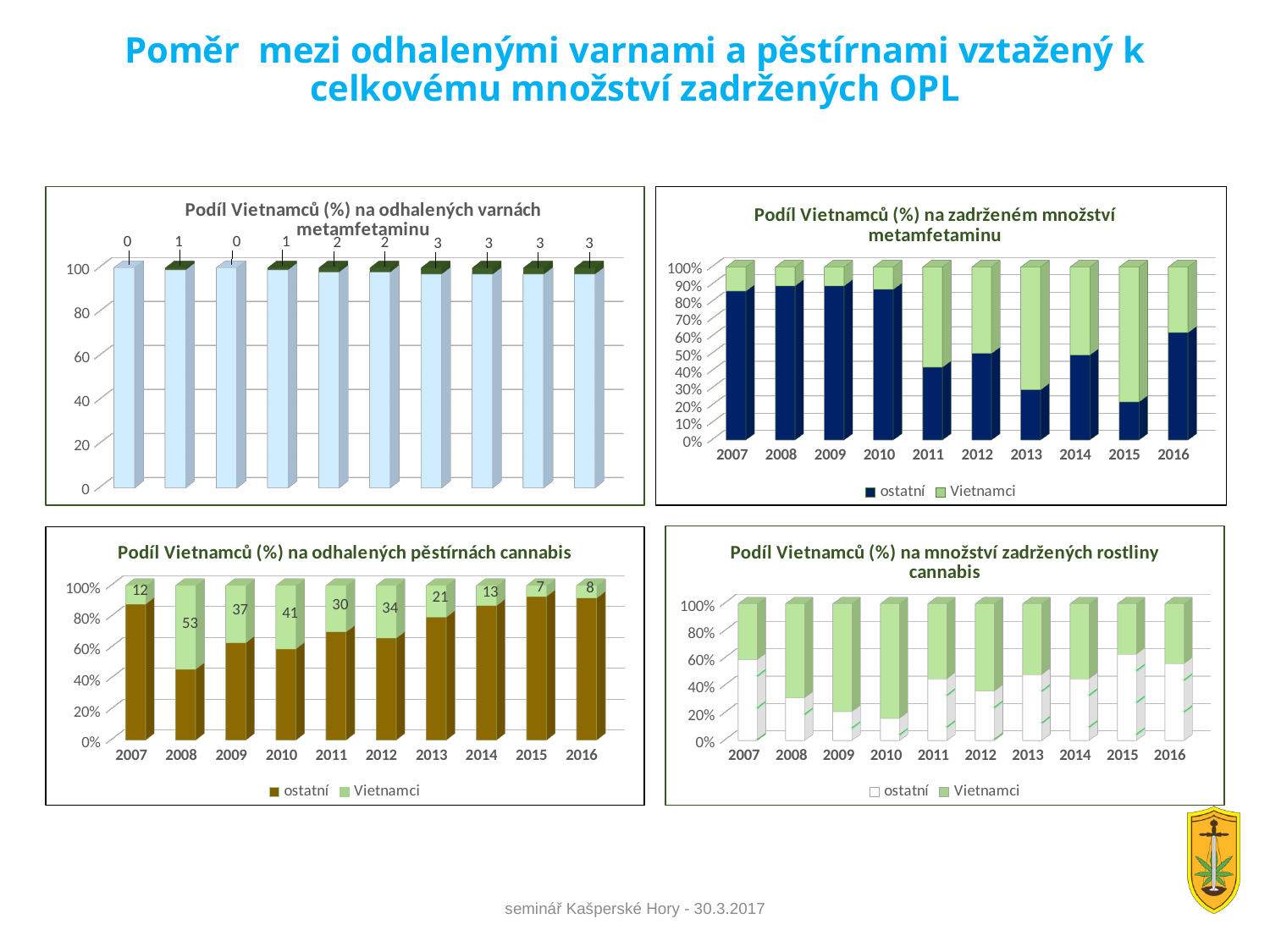
In the chart 'Podíl Vietnamců (%) na odhalených pěstírnách cannabis', which year has the lowest labelled Vietnamci value? 2015 In the chart 'Podíl Vietnamců (%) na množství zadržených rostliny cannabis', is the ostatní share in 2010 greater or less than 20%? less In the chart 'Podíl Vietnamců (%) na zadrženém množství metamfetaminu', is the ostatní share in 2015 greater or less than 40%? less In the chart 'Podíl Vietnamců (%) na odhalených pěstírnách cannabis', what is the value labelled for Vietnamci in 2008? 53 In the chart 'Podíl Vietnamců (%) na odhalených pěstírnách cannabis', which year has the highest labelled Vietnamci value? 2008 In the chart 'Podíl Vietnamců (%) na odhalených pěstírnách cannabis', what is the value labelled for Vietnamci in 2013? 21 In the chart 'Podíl Vietnamců (%) na odhalených pěstírnách cannabis', what is the difference between the Vietnamci labels for 2008 and 2007? 41 How many series does the legend of the chart 'Podíl Vietnamců (%) na množství zadržených rostliny cannabis' list? 2 In the chart 'Podíl Vietnamců (%) na odhalených pěstírnách cannabis', which year has the larger Vietnamci label, 2009 or 2010? 2010 How many bars are shown in the chart 'Podíl Vietnamců (%) na odhalených varnách metamfetaminu'? 10 In the chart 'Podíl Vietnamců (%) na zadrženém množství metamfetaminu', is the ostatní share in 2007 greater or less than 70%? greater In the chart 'Podíl Vietnamců (%) na zadrženém množství metamfetaminu', which year has the lowest ostatní share? 2015